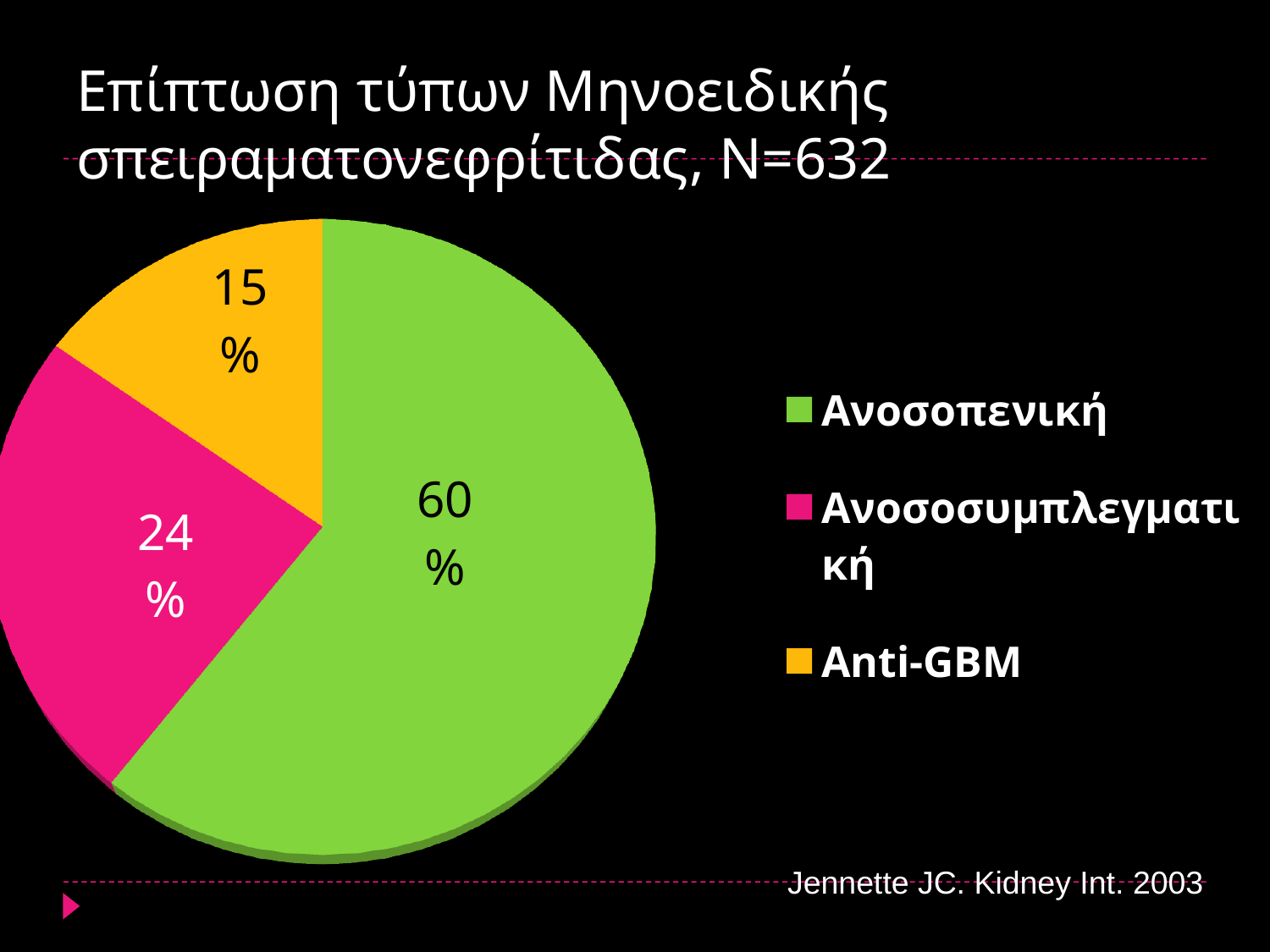
What percentage of the pie does the Ανοσοσυμπλεγματική slice represent? 24% Which is larger, the Ανοσοσυμπλεγματική slice or the Anti-GBM slice? Ανοσοσυμπλεγματική What kind of chart is shown on the slide? pie chart Which category has the smallest share of the pie? Anti-GBM How many slices does the pie chart have? 3 What colour is the Anti-GBM slice? yellow What percentage of the pie does the Anti-GBM slice represent? 15% How many entries does the legend list? 3 What is the difference in percentage points between the Ανοσοπενική and Ανοσοσυμπλεγματική slices? 36 What percentage of the pie does the Ανοσοπενική slice represent? 60% Which category has the largest share of the pie? Ανοσοπενική What is the difference in percentage points between the Ανοσοσυμπλεγματική and Anti-GBM slices? 9